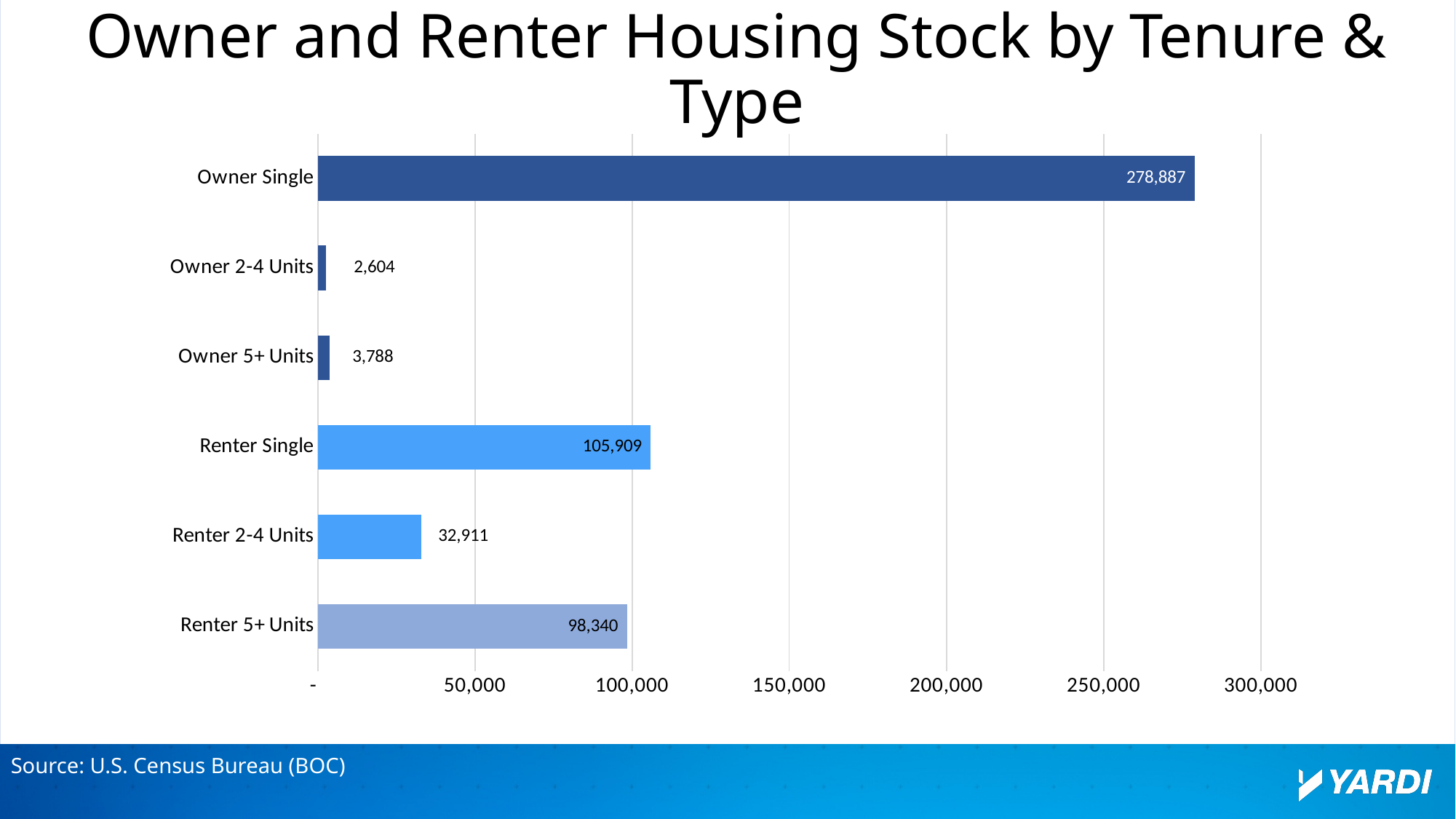
Which category has the highest value? Owner Single How many categories are shown in the chart? 6 Which is larger, Owner 5+ Units or Owner 2-4 Units? Owner 5+ Units Is the value for Renter Single greater or less than 100,000? greater What is the value for Owner 5+ Units? 3,788 What is the value for Owner Single? 278,887 What kind of chart is shown on the slide? Bar chart What is the difference between Renter Single and Renter 5+ Units? 7,569 What is the title of the chart? Owner and Renter Housing Stock by Tenure & Type What is the value for Renter 2-4 Units? 32,911 What is the value for Renter 5+ Units? 98,340 Which category has the lowest value? Owner 2-4 Units